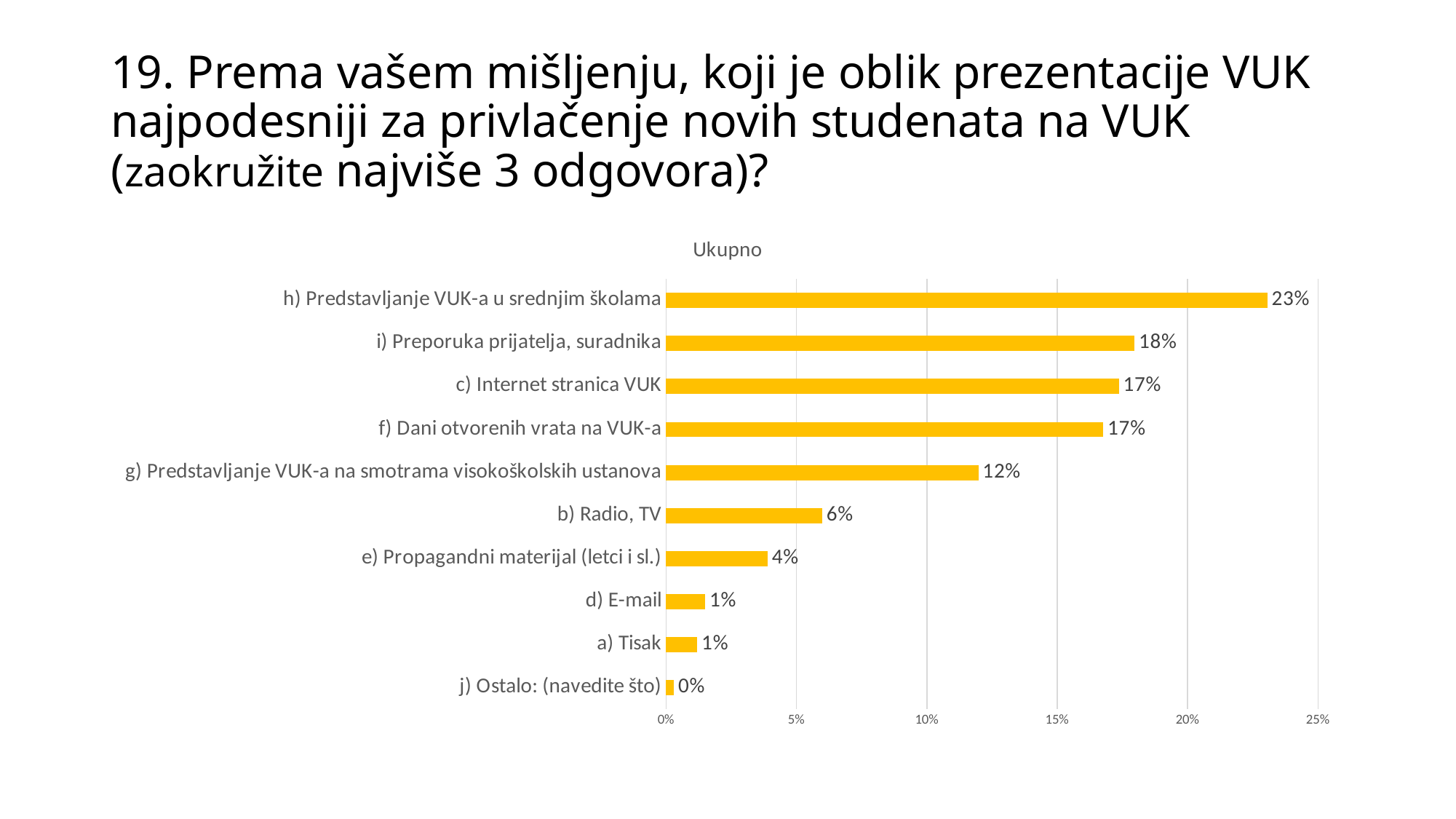
Which category has the lowest value? j) Ostalo: (navedite što) Which category has the highest value? h) Predstavljanje VUK-a u srednjim školama What is the difference between the values for "h) Predstavljanje VUK-a u srednjim školama" and "i) Preporuka prijatelja, suradnika"? 5% What is the title of the chart? Ukupno How many categories are shown in the chart? 10 What kind of chart is shown on the slide? bar chart What is the value for "h) Predstavljanje VUK-a u srednjim školama"? 23% What is the value for "g) Predstavljanje VUK-a na smotrama visokoškolskih ustanova"? 12% Is the value for "g) Predstavljanje VUK-a na smotrama visokoškolskih ustanova" greater or less than 10%? greater What is the value for "i) Preporuka prijatelja, suradnika"? 18% What is the value for "b) Radio, TV"? 6% Which is larger, the value for "b) Radio, TV" or the value for "e) Propagandni materijal (letci i sl.)"? b) Radio, TV